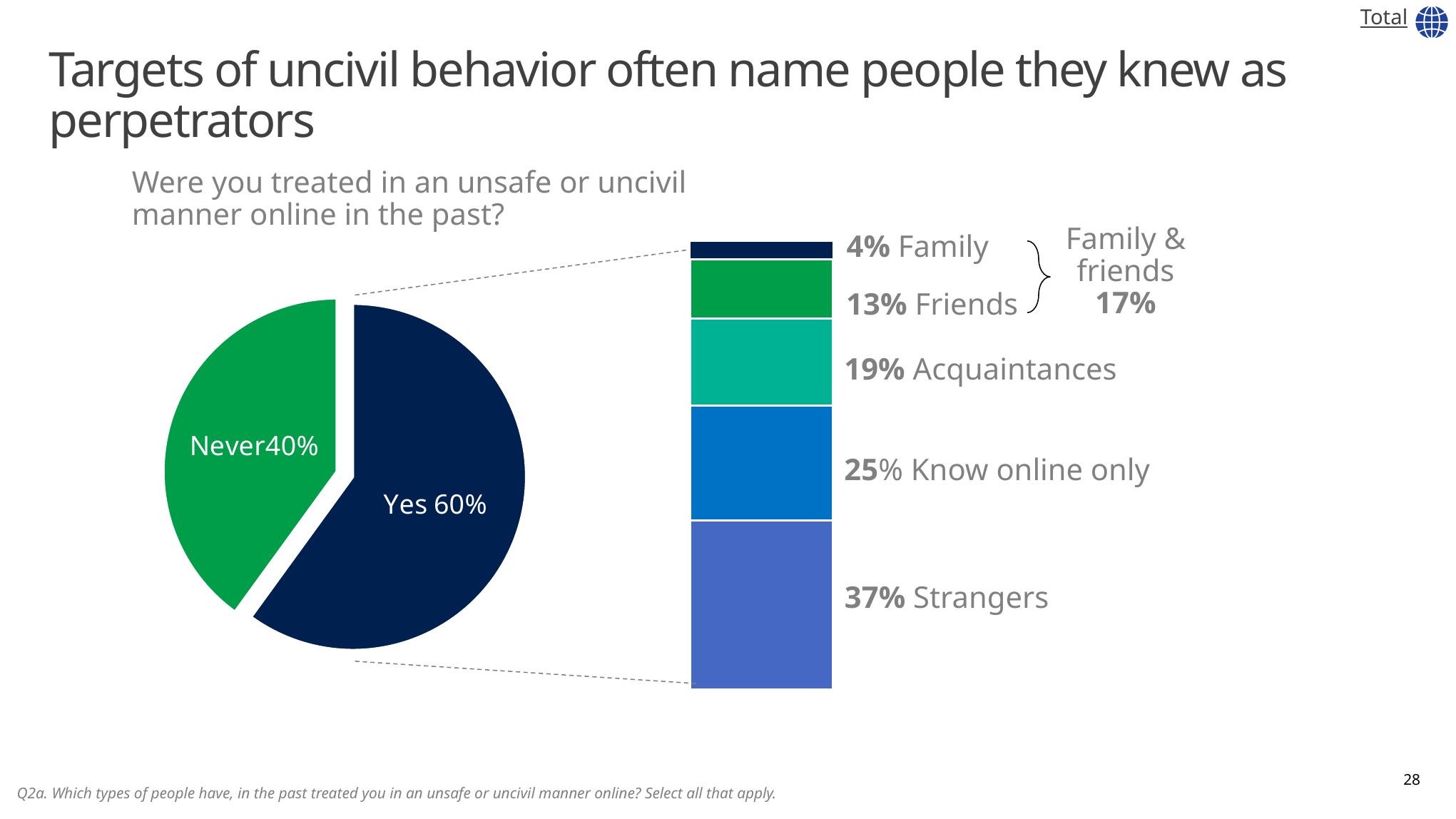
In the pie chart, which slice is larger, Yes or Never? Yes In the stacked bar on the right, what is the difference between Strangers and Friends? 24% What kind of chart is the chart on the left of the slide? Pie chart In the stacked bar on the right, what is the value for Acquaintances? 19% In the stacked bar on the right, what is the value for Strangers? 37% In the pie chart, what share of respondents answered Yes? 60% In the stacked bar on the right, which category has the highest value? Strangers In the pie chart, what share of respondents answered Never? 40% How many slices does the pie chart have? 2 In the stacked bar on the right, what is the value for Know online only? 25% How many categories are shown in the stacked bar on the right? 5 In the stacked bar on the right, which category has the lowest value? Family